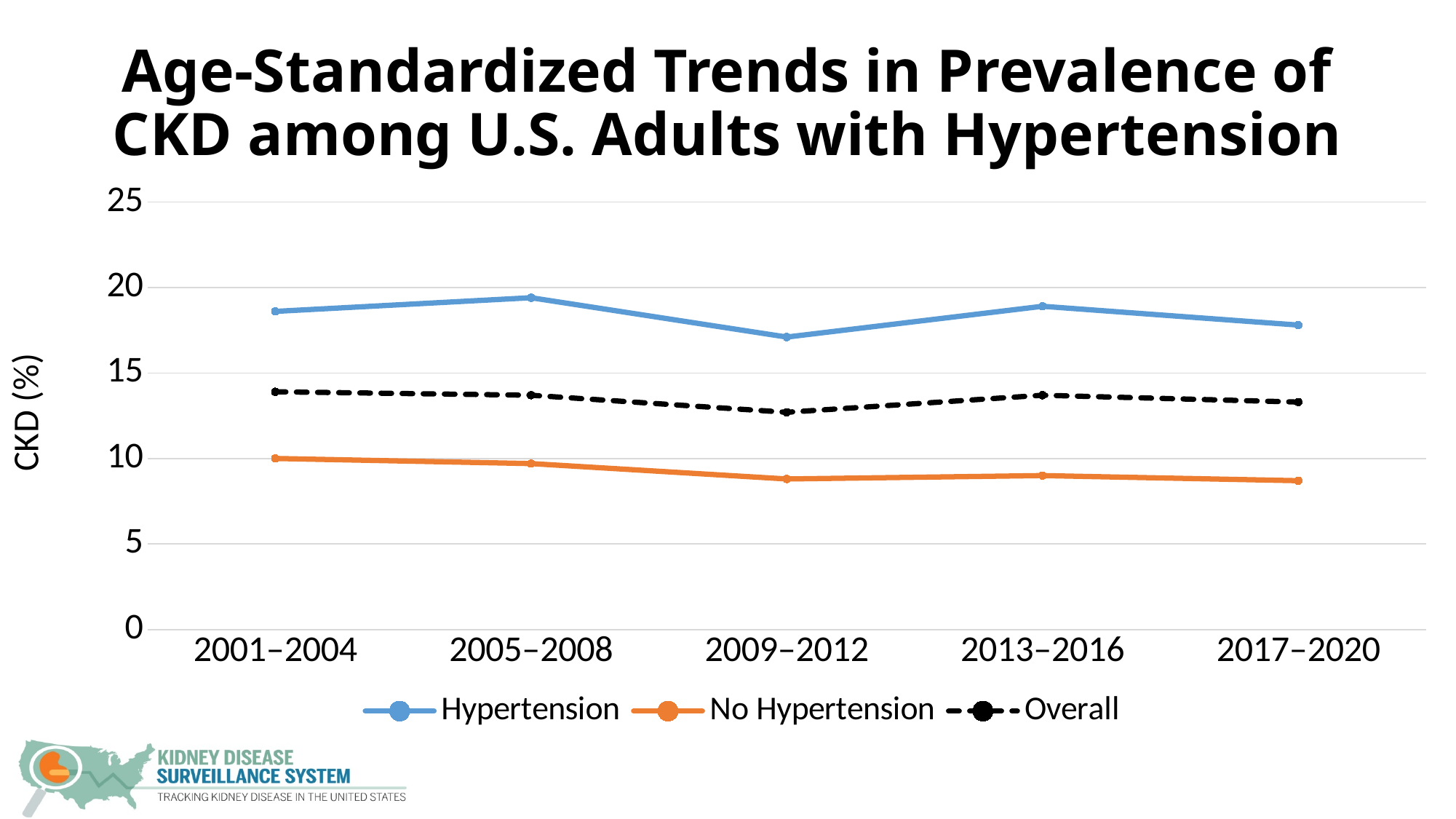
Does the No Hypertension series rise or fall from 2001–2004 to 2017–2020? Fall In which period is the Overall series lowest? 2009–2012 How many time periods are shown on the x axis? 5 Is the value for Hypertension in 2005–2008 greater or less than 15? greater Which series is plotted with a dashed black line? Overall Is the value for No Hypertension in 2009–2012 greater or less than 10? less What kind of chart is shown on the slide? Line chart Is the value for Hypertension in 2009–2012 greater or less than 20? less What is the label of the y axis? CKD (%) In which period is the Hypertension series highest? 2005–2008 In 2017–2020, which series has the larger value, Hypertension or No Hypertension? Hypertension How many series does the legend list? 3